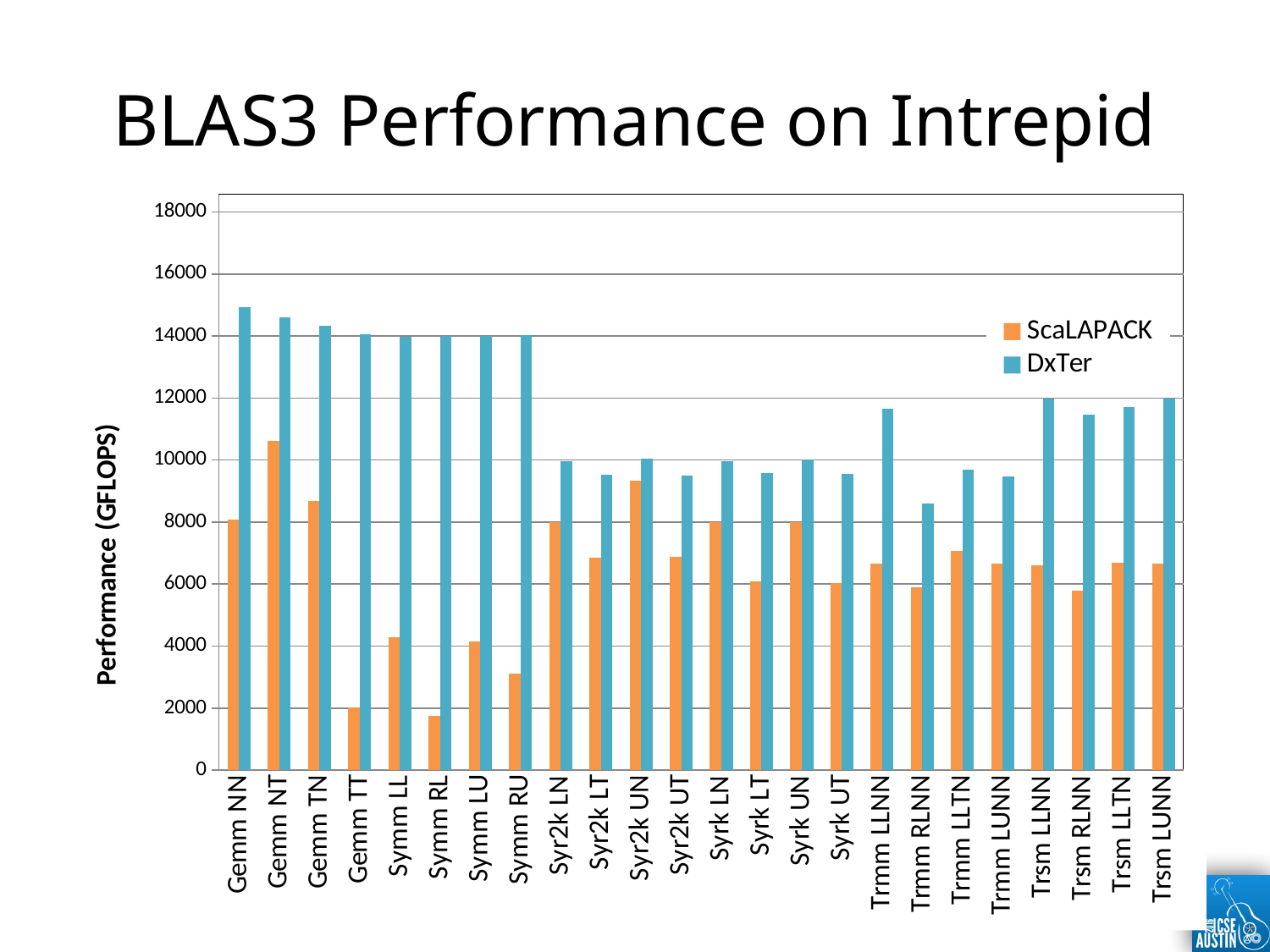
How many series does the legend list? 2 Is the ScaLAPACK value for Symm LL greater or less than 6000? less Which category has the lowest DxTer value? Trmm RLNN Which series is shown in orange? ScaLAPACK How many categories are shown on the x axis? 24 What kind of chart is shown on the slide? bar chart Is the DxTer value for Gemm TT greater or less than 12000? greater Is the ScaLAPACK value for Symm RU greater or less than 4000? less What is the label of the y axis? Performance (GFLOPS) Which category has the highest ScaLAPACK value? Gemm NT For Gemm TT, which is larger: the ScaLAPACK value or the DxTer value? DxTer